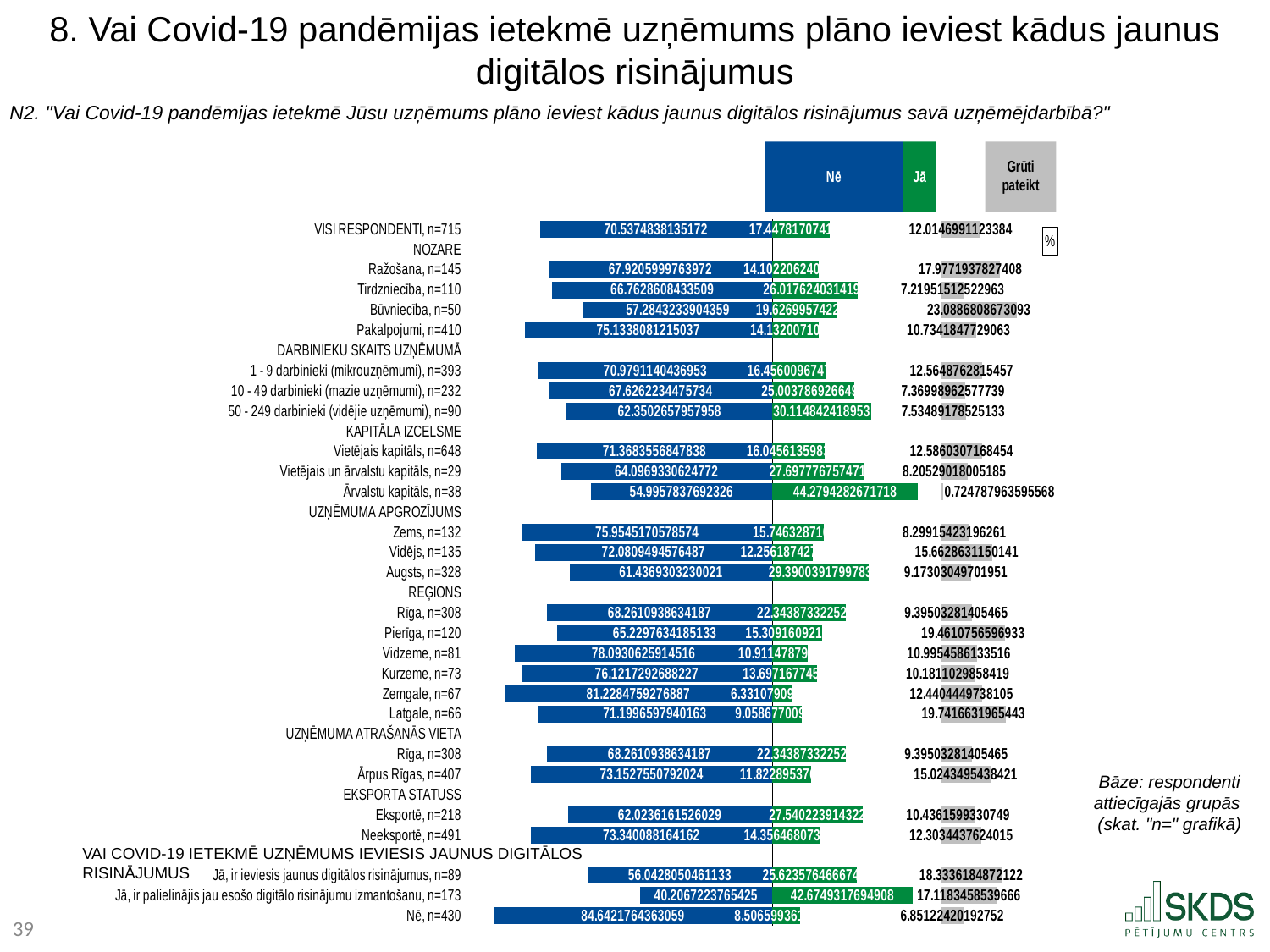
What kind of chart is shown on the slide? Stacked horizontal bar chart What is the "Nē" value for VISI RESPONDENTI, n=715? 70.5374838135172 How many series does the legend list? 3 Which category has the highest "Jā" value? Ārvalstu kapitāls, n=38 Which category has the lowest "Nē" value? Jā, ir palielinājis jau esošo digitālo risinājumu izmantošanu, n=173 Which has a larger "Nē" value: Pakalpojumi, n=410 or Tirdzniecība, n=110? Pakalpojumi, n=410 What is the difference between the "Nē" values for Pakalpojumi, n=410 and Ražošana, n=145? 7.2132081451065 What is the "Nē" value for Zemgale, n=67? 81.2284759276887 What is the "Jā" value for Ārvalstu kapitāls, n=38? 44.2794282671718 Which category has the highest "Nē" value? Nē, n=430 What are the three legend entries of the chart? Nē, Jā, Grūti pateikt What is the "Grūti pateikt" value for Būvniecība, n=50? 23.0886808673093